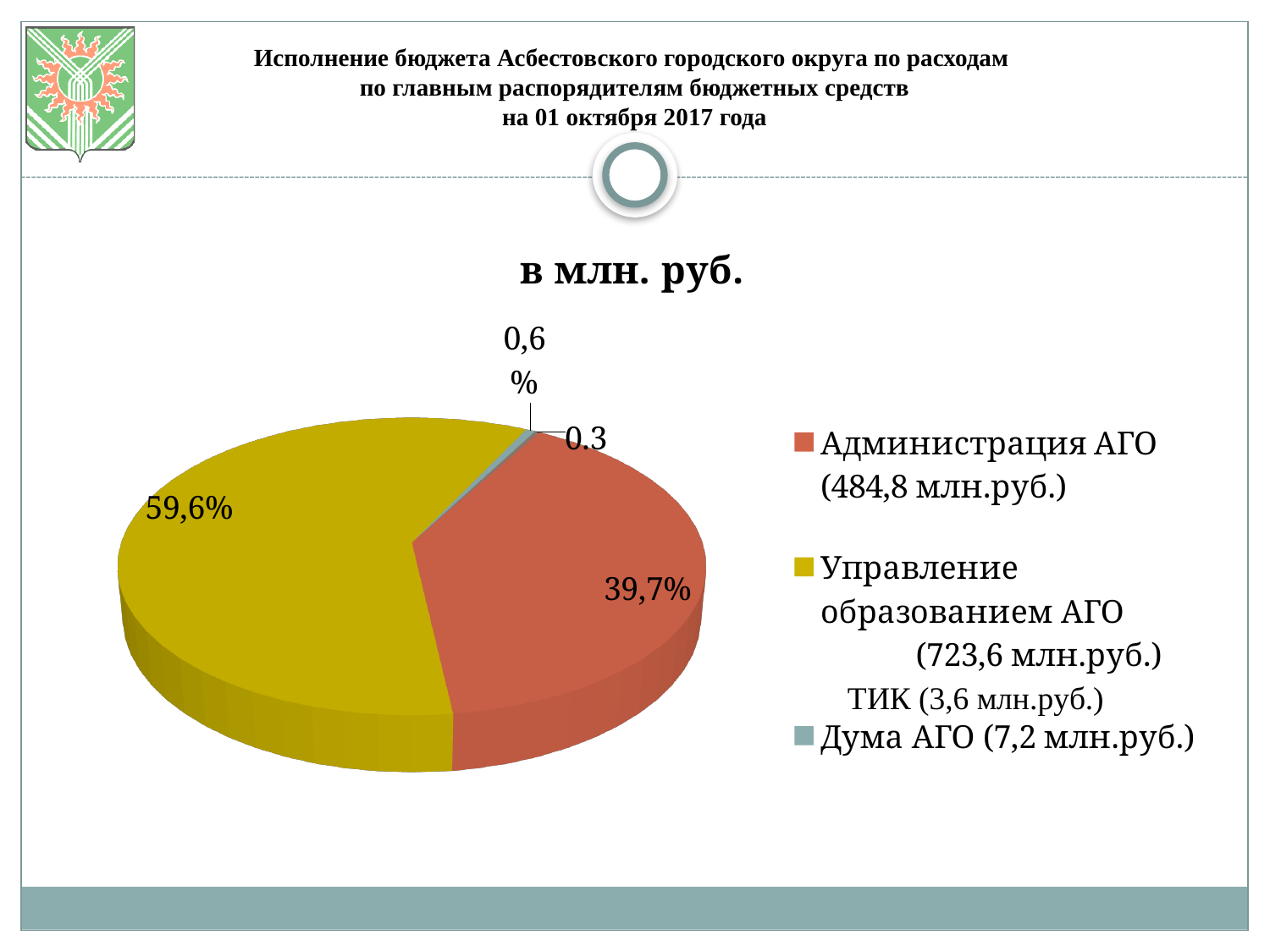
According to the legend, what is the amount for Администрация АГО? 484,8 млн.руб. Which category has the largest slice of the pie? Управление образованием АГО According to the legend, what is the amount for Управление образованием АГО? 723,6 млн.руб. Which is larger, the slice for Администрация АГО or the slice for Дума АГО? Администрация АГО What kind of chart is shown on the slide? pie chart What percentage share of the pie does Управление образованием АГО have? 59,6% What is the title of the chart? в млн. руб. According to the legend, what is the amount for ТИК? 3,6 млн.руб. What is the difference between the amounts for Управление образованием АГО and Администрация АГО? 238,8 млн.руб. What percentage share of the pie does Дума АГО have? 0,6% What percentage share of the pie does Администрация АГО have? 39,7% According to the legend, what is the amount for Дума АГО? 7,2 млн.руб.